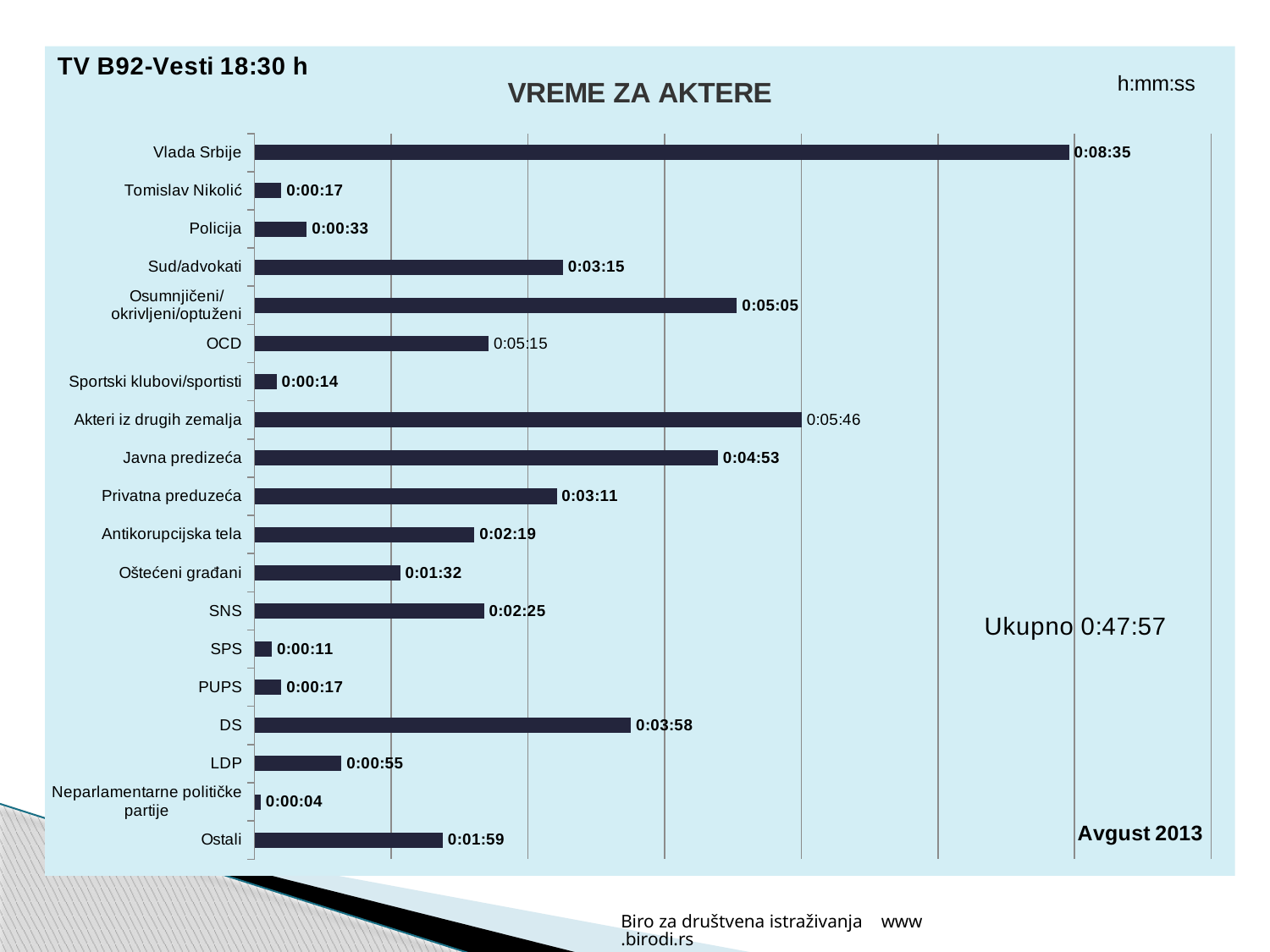
What is the difference between the value for Vlada Srbije and the value for DS? 0:04:37 Which is larger, the value for Javna predizeća or the value for DS? Javna predizeća What is the value for SNS? 0:02:25 What total (Ukupno) is shown on the chart? 0:47:57 Which category has the lowest value? Neparlamentarne političke partije What is the value for LDP? 0:00:55 How many categories are shown in the chart? 19 What is the value for Akteri iz drugih zemalja? 0:05:46 How much time is shown for Vlada Srbije? 0:08:35 Which category has the highest value? Vlada Srbije What kind of chart is shown on the slide? bar chart What is the title of the chart? VREME ZA AKTERE